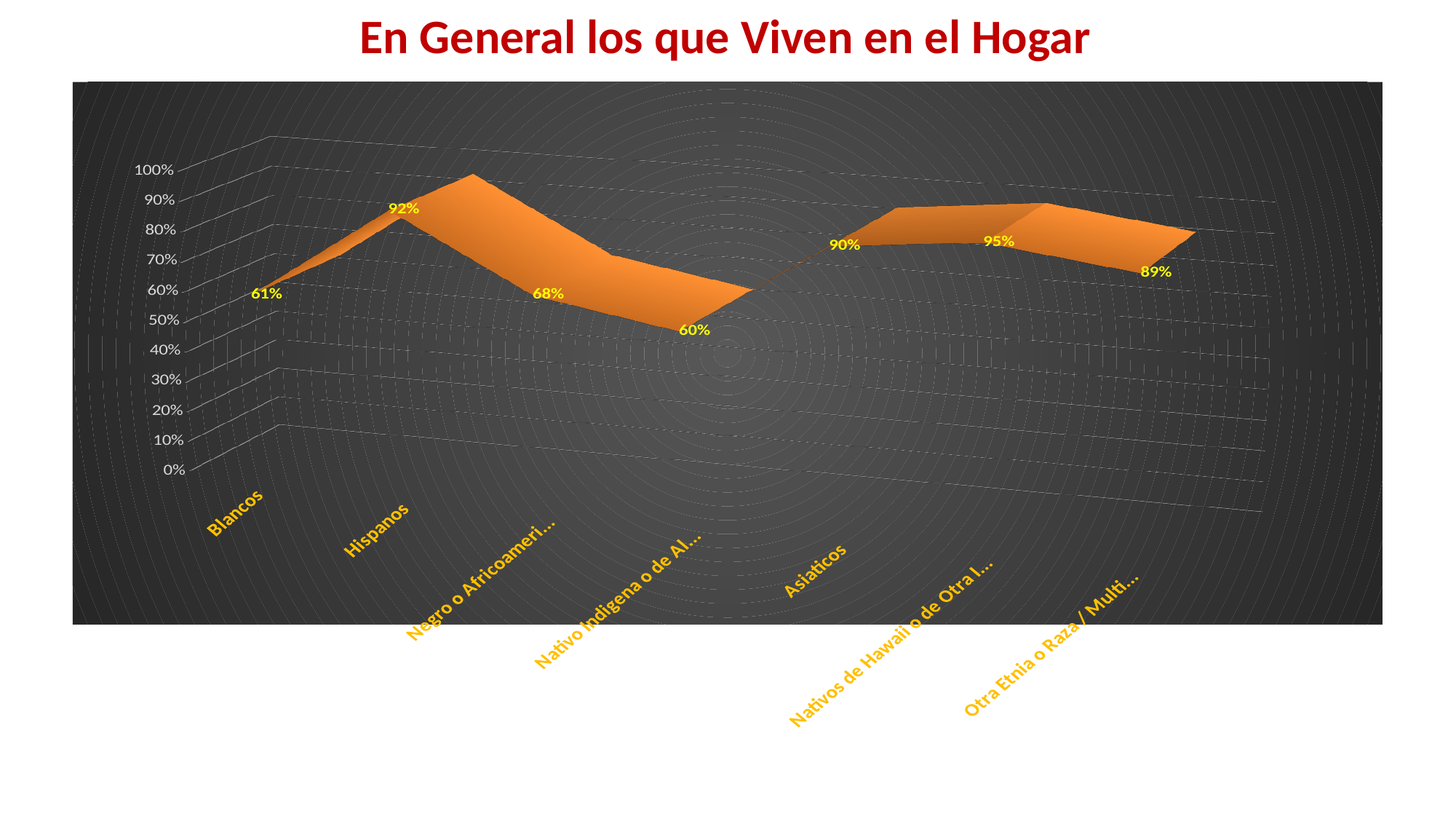
Is the value for Blancos greater or less than 50%? greater How many categories are plotted on the chart? 7 What is the lowest value shown on the chart? 60% What kind of chart is shown on the slide? 3D line chart What is the title of the chart? En General los que Viven en el Hogar What is the highest value shown on the chart? 95% What colour is the plotted area in the chart? Orange What is the difference between the values for Hispanos and Blancos? 31 percentage points What is the value for Hispanos? 92% Which is larger, the value for Hispanos or the value for Asiaticos? Hispanos What is the value for Blancos? 61% What is the value for Asiaticos? 90%